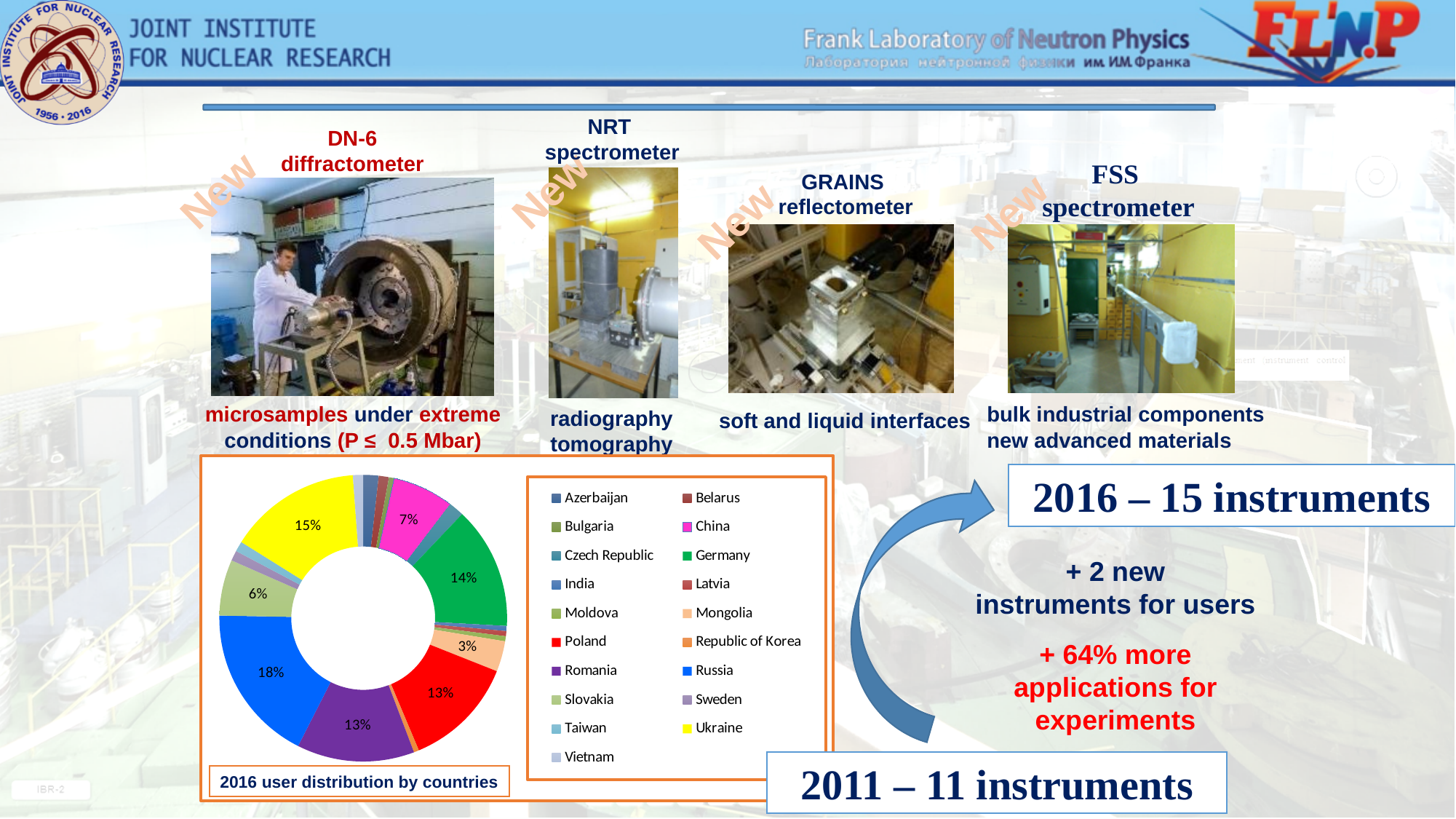
By how many percentage points does Russia's share exceed Ukraine's share? 3 percentage points How many countries are listed in the chart's legend? 19 What share of users in 2016 came from China? 7% What colour represents Ukraine in the chart? Yellow Which country has the largest share of users in the 2016 distribution? Russia What share of users in 2016 came from Mongolia? 3% What share of users in 2016 came from Russia? 18% Which has the larger share of users, Germany or China? Germany What share of users in 2016 came from Germany? 14% What share of users in 2016 came from Ukraine? 15% What kind of chart is used to show the 2016 user distribution by countries? Doughnut (pie) chart What is the chart's title? 2016 user distribution by countries